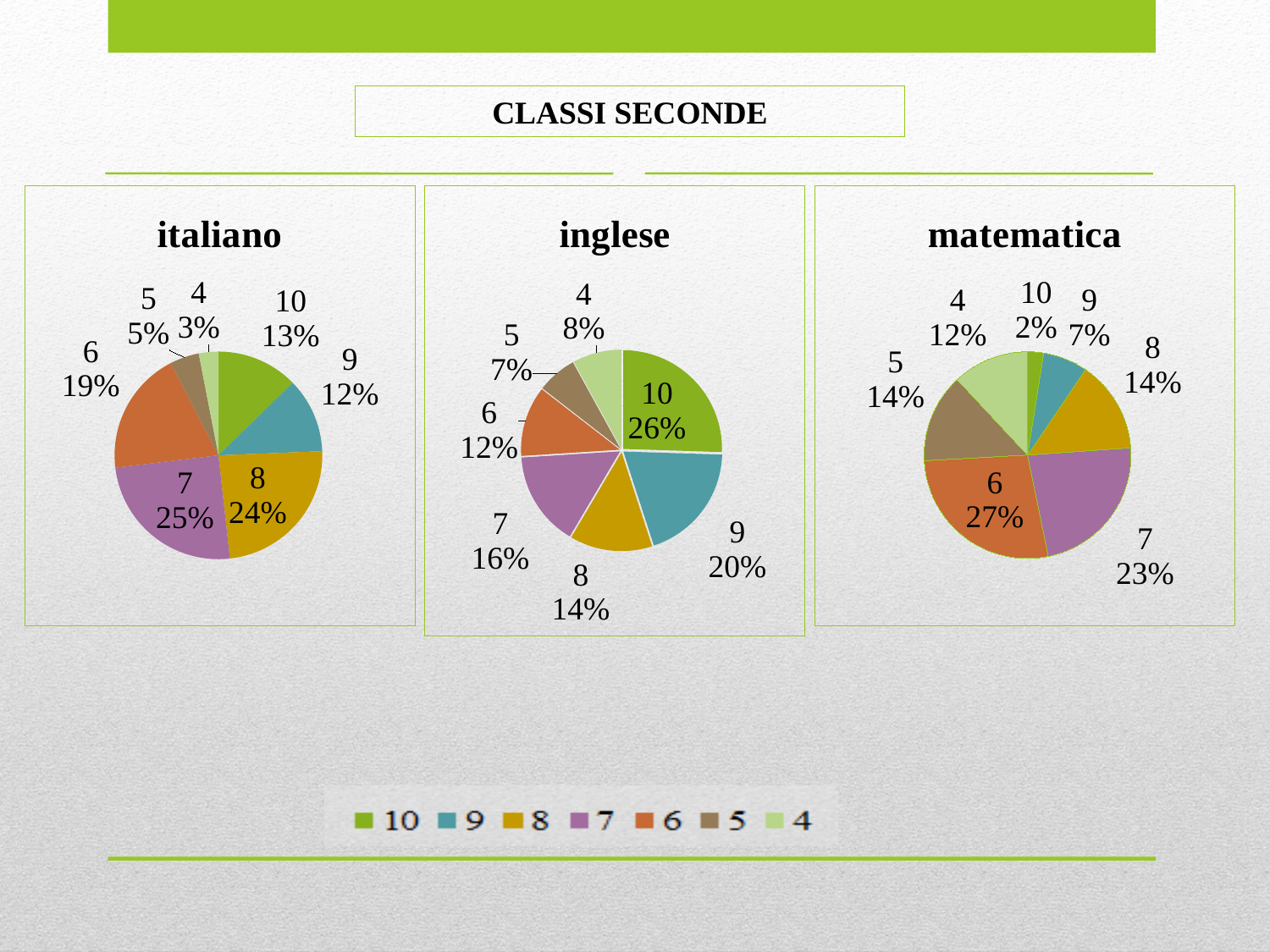
In the 'italiano' pie chart, what share does grade 7 have? 25% In the 'inglese' pie chart, what share does grade 6 have? 12% How many slices does the 'matematica' pie chart have? 7 In the 'inglese' pie chart, which is larger: the share of grade 9 or the share of grade 7? 9 In the 'inglese' pie chart, what share does grade 10 have? 26% What kind of chart is used for 'italiano', 'inglese' and 'matematica'? pie chart In the 'italiano' pie chart, what is the difference between the shares of grade 8 and grade 10? 11% In the 'matematica' pie chart, which grade has the largest slice? 6 In the 'inglese' pie chart, which grade has the smallest slice? 5